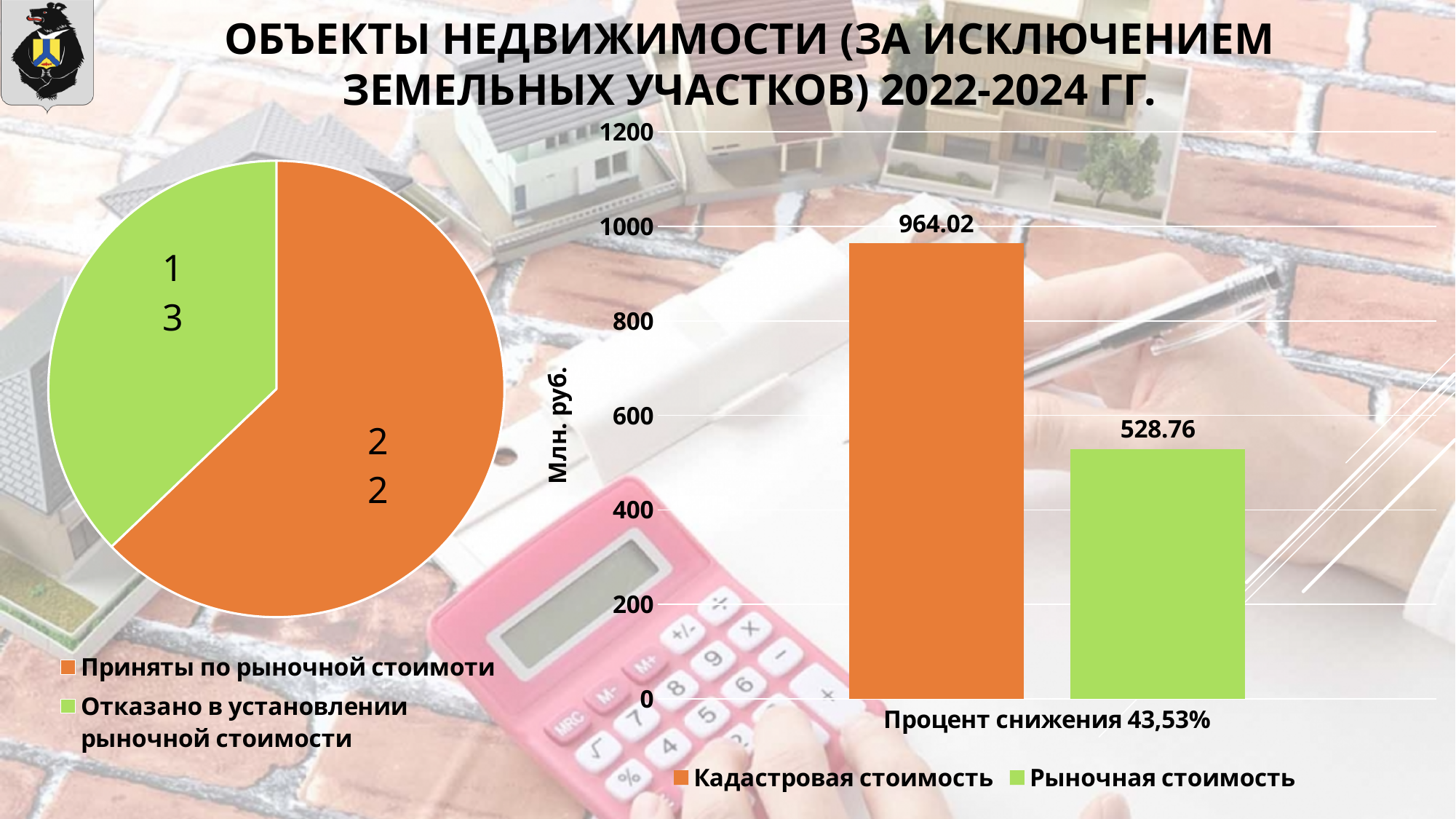
What kind of chart is shown on the left side of the slide? pie chart On the bar chart on the right, what is the value for Кадастровая стоимость? 964.02 On the pie chart on the left, how many slices are there? 2 On the bar chart on the right, which series has the higher value, Кадастровая стоимость or Рыночная стоимость? Кадастровая стоимость On the bar chart on the right, what is the label on the vertical axis? Млн. руб. On the bar chart on the right, is the value for Рыночная стоимость greater or less than 600? less On the bar chart on the right, how many series does the legend list? 2 On the pie chart on the left, which slice is larger, Приняты по рыночной стоимоти or Отказано в установлении рыночной стоимости? Приняты по рыночной стоимоти On the bar chart on the right, what is the value for Рыночная стоимость? 528.76 On the bar chart on the right, what is the category label shown under the bars? Процент снижения 43,53% On the bar chart on the right, what is the difference between Кадастровая стоимость and Рыночная стоимость? 435.26 What kind of chart is shown on the right side of the slide? bar chart